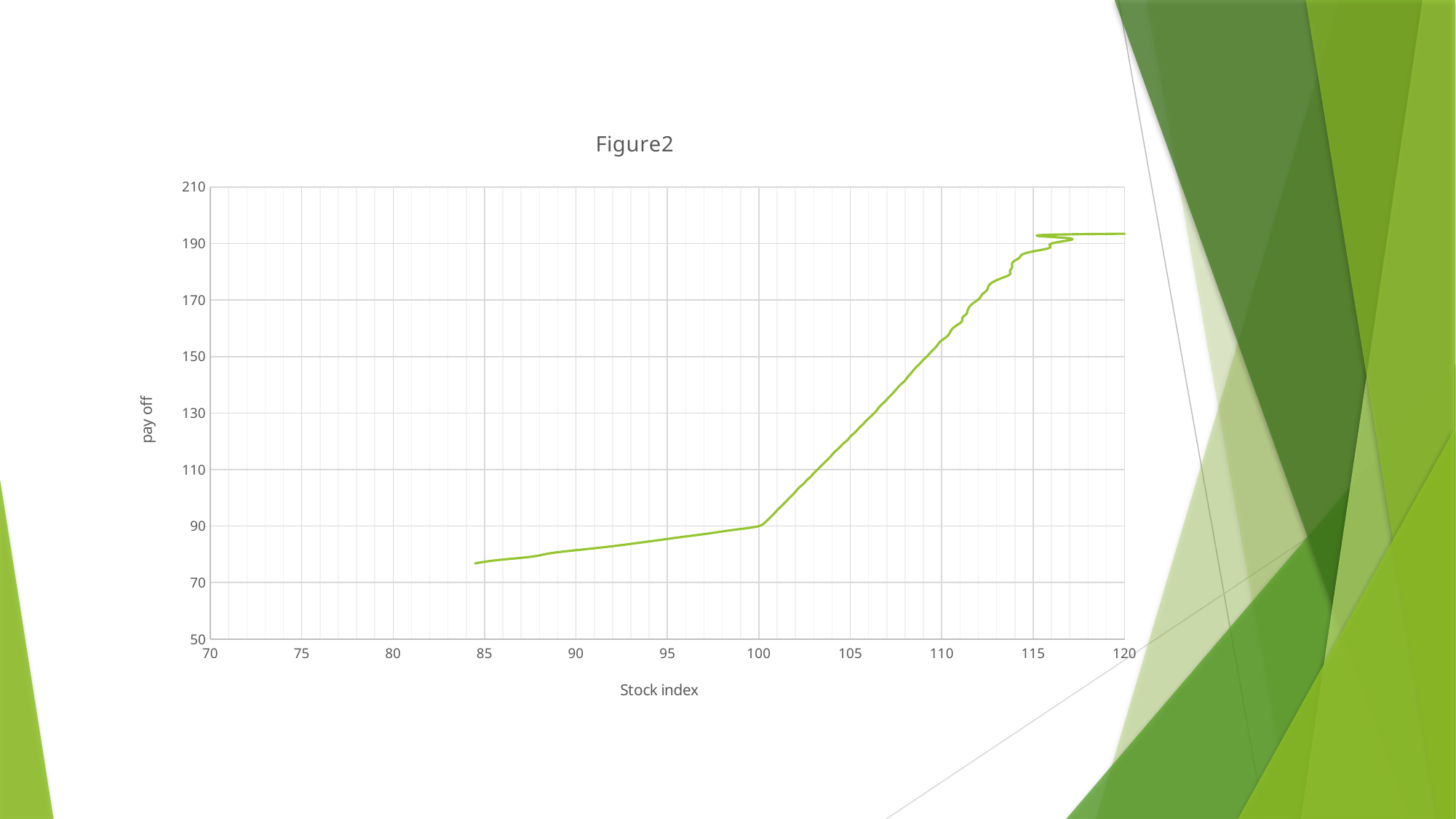
Is the pay off at a stock index of 110 greater or less than 130? greater What is the label of the x axis? Stock index What kind of chart is shown on the slide? line chart Is the pay off at a stock index of 95 greater or less than 110? less Is the pay off higher at a stock index of 110 or at a stock index of 100? 110 What is the title of the chart? Figure2 Is the pay off at a stock index of 105 greater or less than 110? greater How many lines are plotted on the chart? 1 Does the pay off rise or fall as the stock index increases from 85 to 115? rise